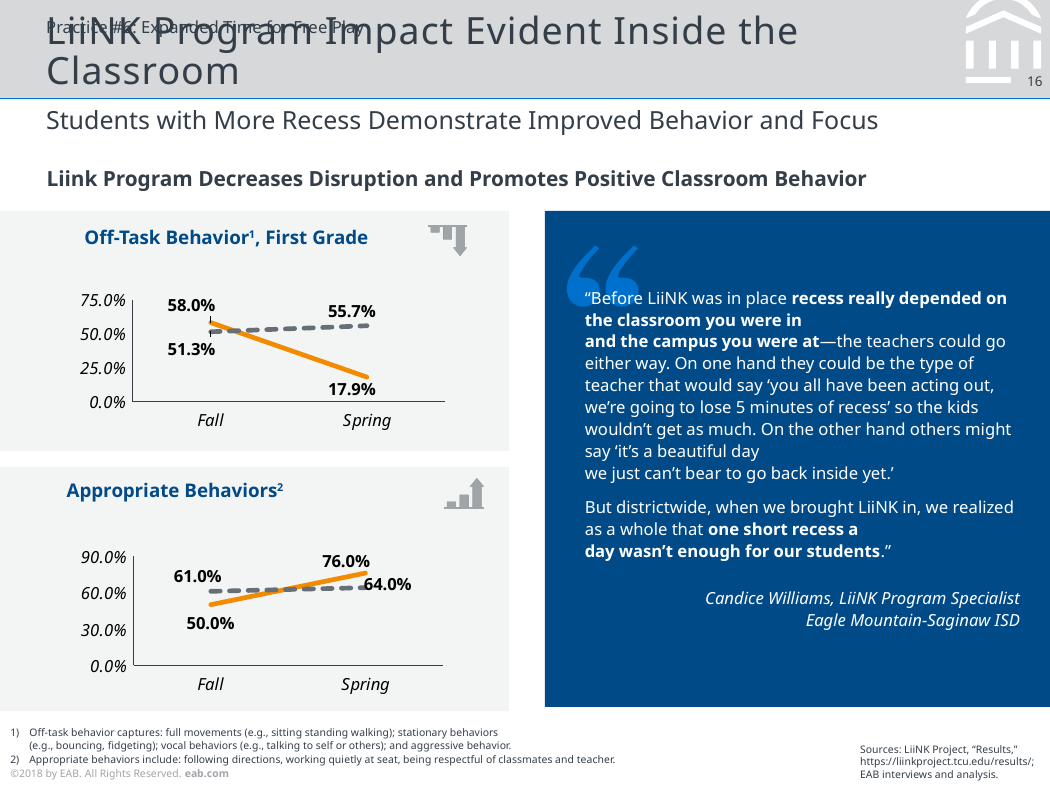
In the Appropriate Behaviors chart, what is the Fall value of the gray dashed line? 61.0% In the Off-Task Behavior, First Grade chart, what is the Spring value of the orange solid line? 17.9% How many x-axis categories does the Off-Task Behavior, First Grade chart show? 2 In the Appropriate Behaviors chart, by how much does the orange solid line increase from Fall to Spring? 26.0 percentage points In the Off-Task Behavior, First Grade chart, which line has the higher Spring value, the orange solid line or the gray dashed line? gray dashed line In the Appropriate Behaviors chart, does the orange solid line rise or fall from Fall to Spring? rise In the Off-Task Behavior, First Grade chart, what is the Spring value of the gray dashed line? 55.7% What kind of chart is the Appropriate Behaviors chart? line chart In the Off-Task Behavior, First Grade chart, what is the Fall value of the orange solid line? 58.0% In the Off-Task Behavior, First Grade chart, by how much does the orange solid line fall from Fall to Spring? 40.1 percentage points In the Off-Task Behavior, First Grade chart, does the orange solid line rise or fall from Fall to Spring? fall In the Appropriate Behaviors chart, what is the Spring value of the orange solid line? 76.0%